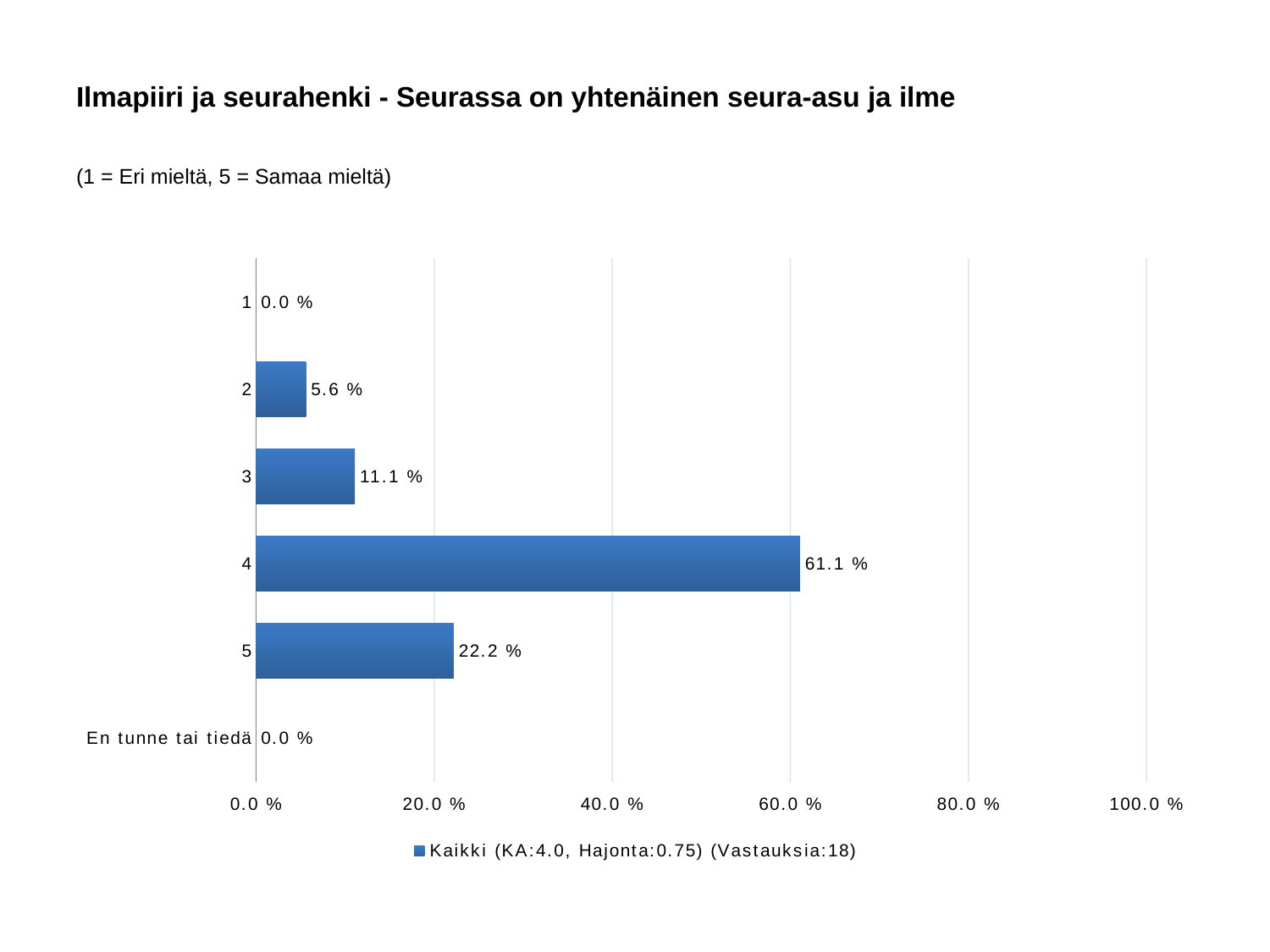
What is the value for category 2? 5.6 % How many series does the legend list? 1 Which category has the highest value? 4 What kind of chart is shown on the slide? bar chart What is the value for category 4? 61.1 % Is the value for category 4 greater or less than 60.0 %? greater What is the legend entry of the chart? Kaikki (KA:4.0, Hajonta:0.75) (Vastauksia:18) Which is larger, the value for category 3 or the value for category 2? 3 What is the value for category 5? 22.2 % How many categories are shown on the chart? 6 What is the value for 'En tunne tai tiedä'? 0.0 % What is the difference between the values for category 4 and category 5? 38.9 %